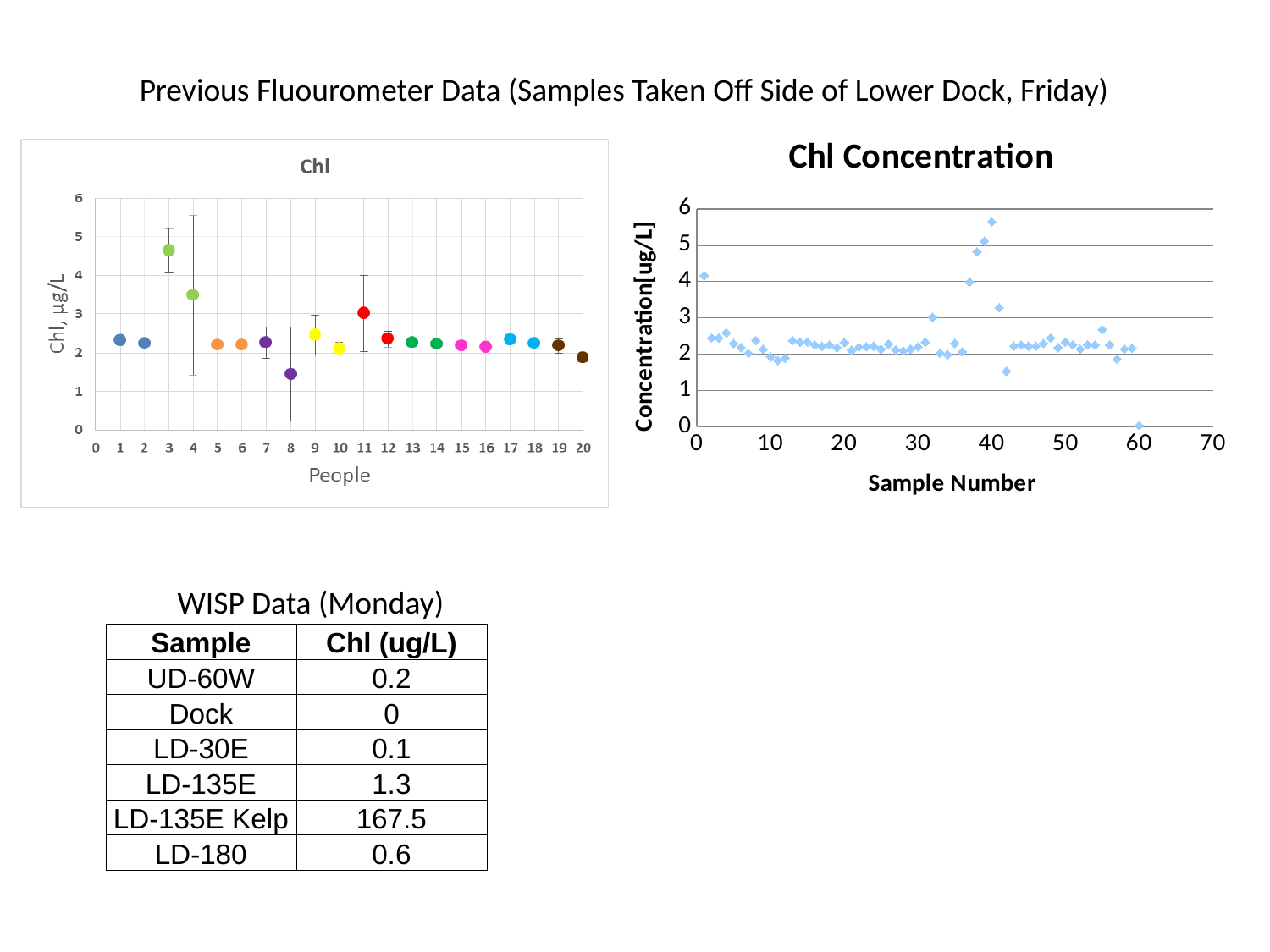
What is the x-axis title of the "Chl Concentration" chart on the right? Sample Number In the "Chl Concentration" chart on the right, is the highest plotted value greater or less than 5? greater In the "Chl" chart on the left, which is larger, the value for person 3 or the value for person 8? person 3 In the "Chl" chart on the left, is the value for person 8 greater or less than 2? less In the "Chl" chart on the left, is the value for person 4 greater or less than 3? greater In the "Chl" chart on the left, which person has the lowest Chl value? 8 What kind of chart is the "Chl" chart on the left of the slide? scatter chart In the "Chl" chart on the left, which person has the highest Chl value? 3 What kind of chart is the "Chl Concentration" chart on the right of the slide? scatter chart In the "Chl" chart on the left, how many people (data points) are plotted? 20